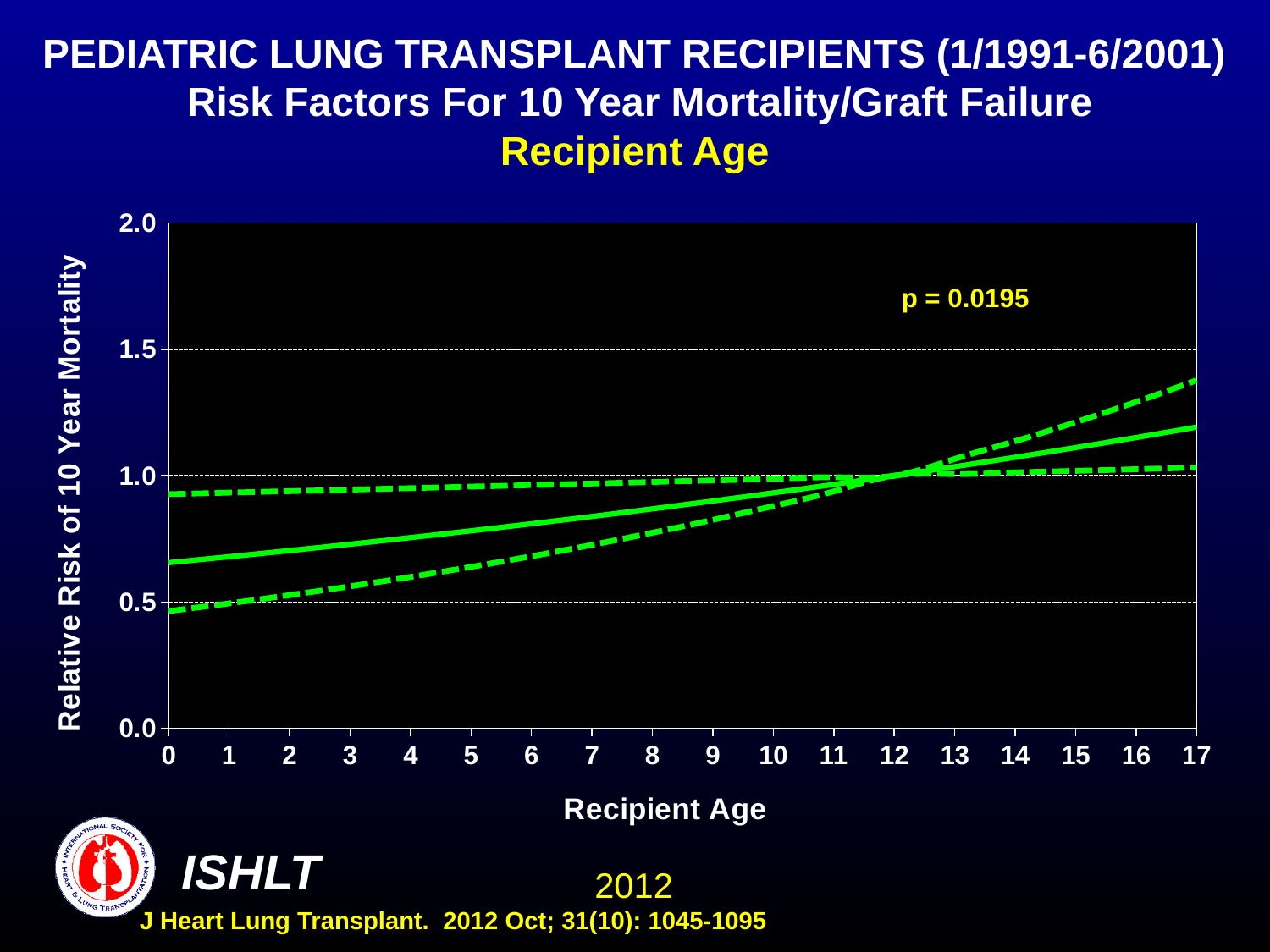
Is the value of the upper dashed line at recipient age 0 greater or less than 1.0? less Is the value of the solid line at recipient age 0 greater or less than 1.0? less Which is larger, the solid line's value at recipient age 0 or at recipient age 17? recipient age 17 What type of chart is shown on the slide? line chart Is the value of the solid line at recipient age 0 greater or less than 0.5? greater What is the label of the y axis? Relative Risk of 10 Year Mortality How many lines are plotted on the chart? 3 What p-value is printed on the chart? p = 0.0195 Does the solid line for relative risk rise or fall as recipient age increases from 0 to 17? rise